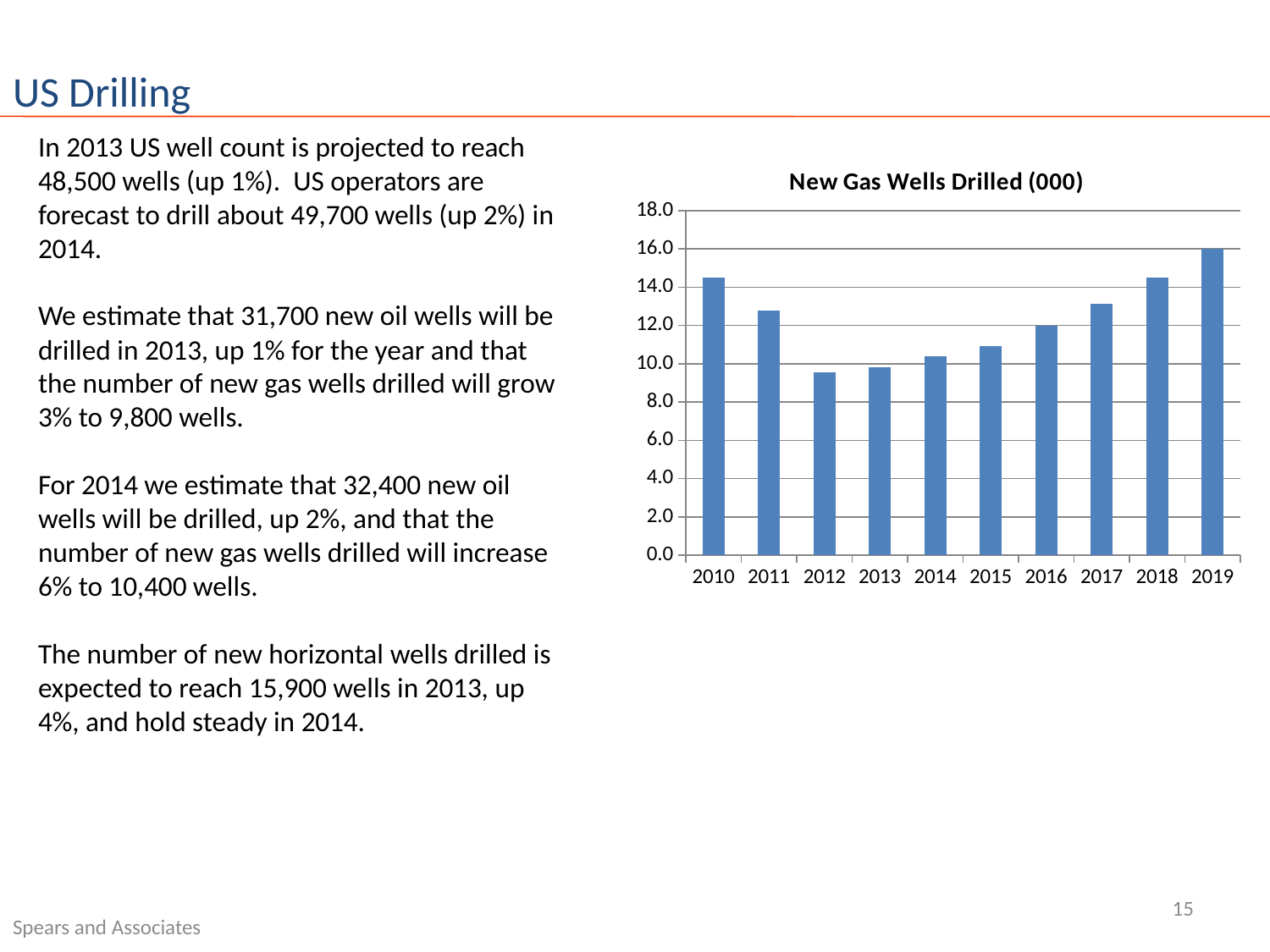
What is the title of the chart? New Gas Wells Drilled (000) Which year has the highest value in the chart? 2019 Which is larger, the value for 2010 or the value for 2011? 2010 Is the value for 2017 greater or less than 12.0? greater Is the value for 2012 greater or less than 10.0? less How many years are shown on the x axis of the chart? 10 What type of chart is shown on the slide? Bar chart Is the value for 2010 greater or less than 14.0? greater Do the values rise or fall from 2012 to 2019? rise Which is larger, the value for 2013 or the value for 2016? 2016